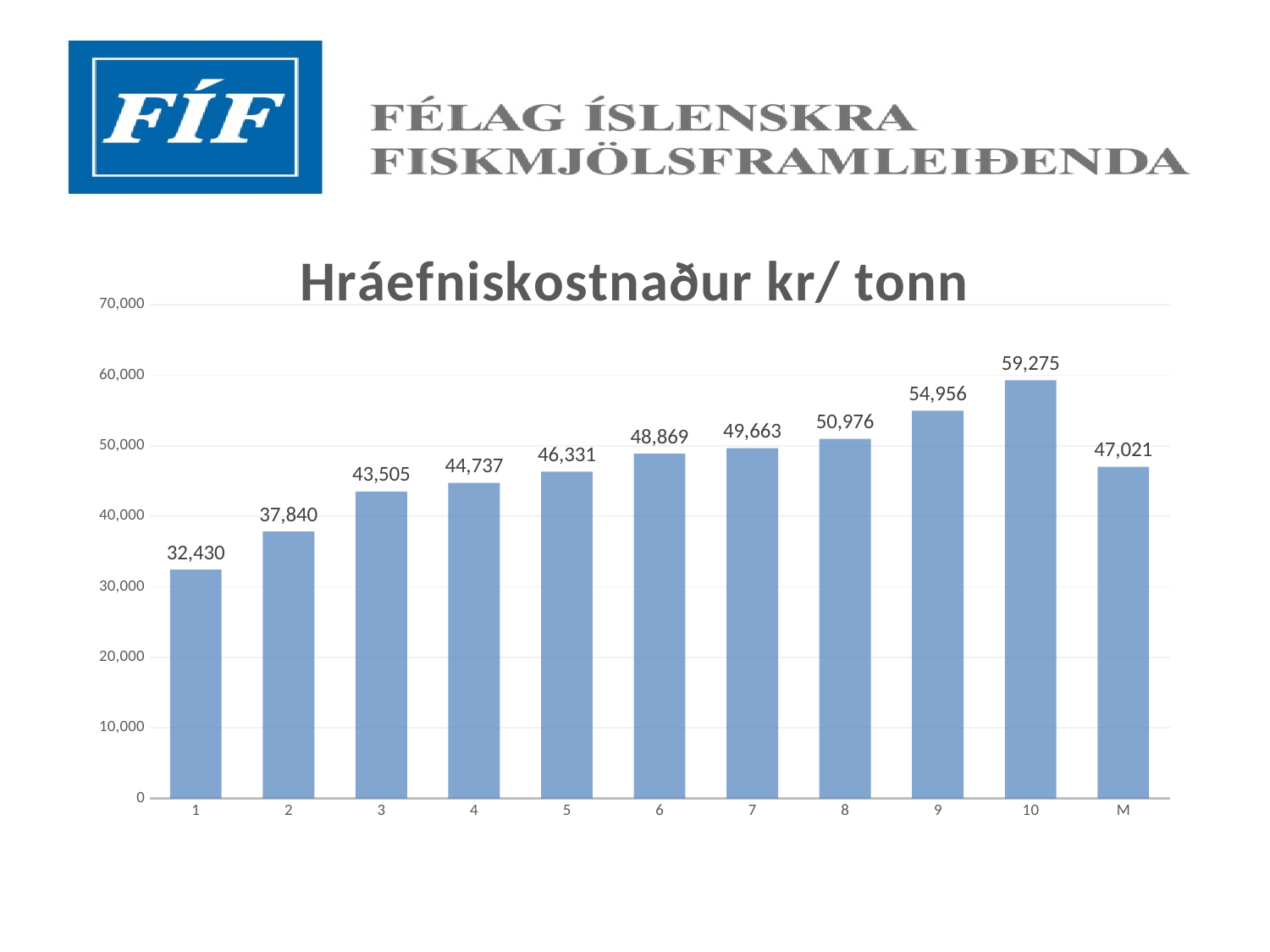
What kind of chart is shown on the slide? bar chart What is the value for category 7? 49,663 Which category has the lowest value? 1 Which is larger, the value for category 5 or the value for category M? M What is the difference between the values for category 10 and category 1? 26,845 Which category has the highest value? 10 What is the value for category M? 47,021 What is the difference between the values for category 9 and category 8? 3,980 What is the title of the chart? Hráefniskostnaður kr/ tonn What is the value for category 1? 32,430 How many categories are shown on the x axis? 11 Is the value for category 3 greater or less than 40,000? greater